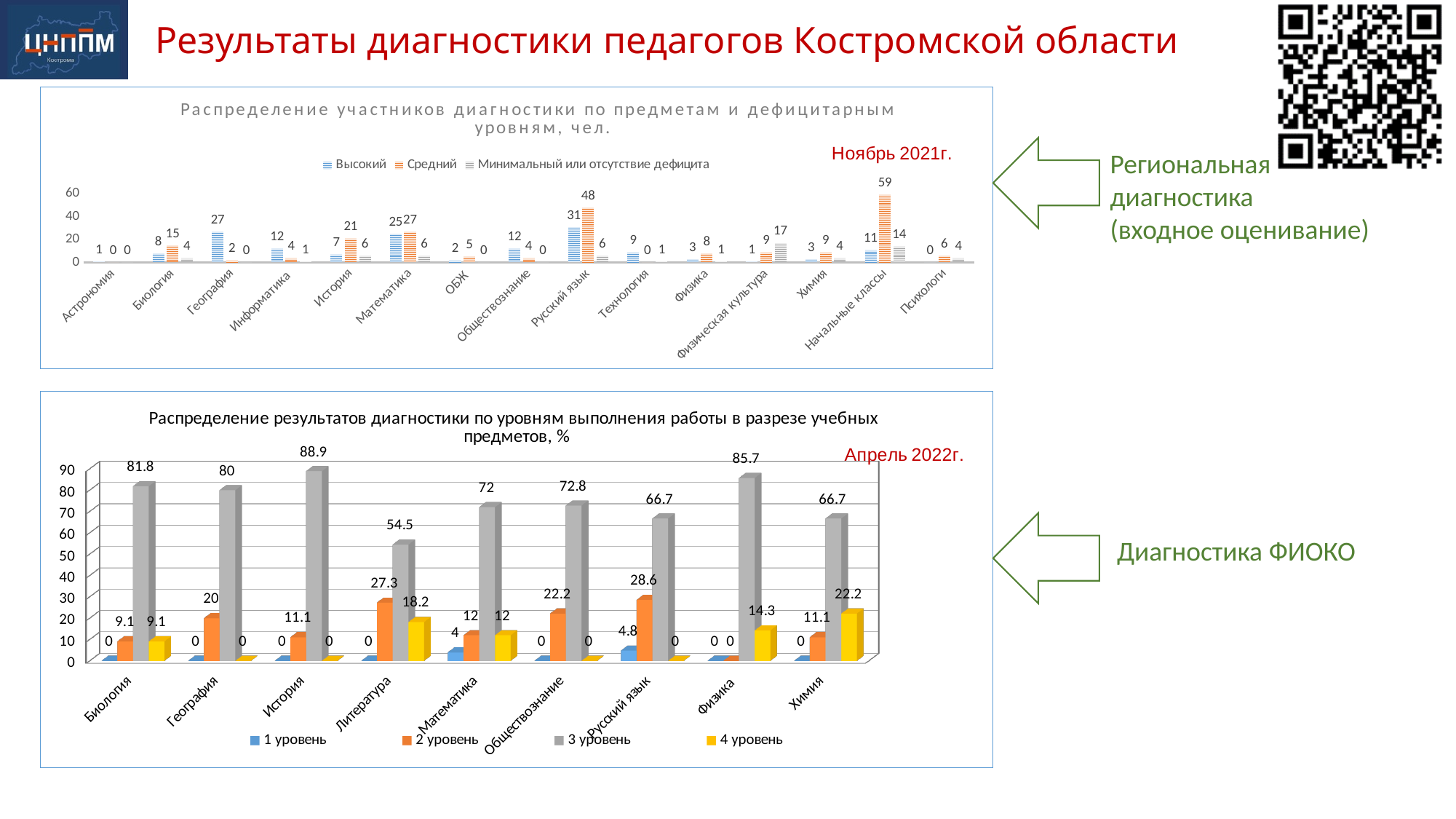
In the bottom chart (Апрель 2022г.), how many series does the legend list? 4 In the top chart (Ноябрь 2021г.), how many series does the legend list? 3 In the bottom chart (Апрель 2022г.), which subject has the lowest value for 3 уровень? Литература In the top chart (Ноябрь 2021г.), what is the value of the Средний series for Начальные классы? 59 In the top chart (Ноябрь 2021г.), how many subject categories are shown on the x axis? 15 In the bottom chart (Апрель 2022г.), which is larger: the 4 уровень value for Химия or for Физика? Химия In the top chart (Ноябрь 2021г.), what is the difference between the Средний and Высокий values for Математика? 2 What type of chart is the bottom chart (Апрель 2022г.)? Bar chart In the top chart (Ноябрь 2021г.), which subject has the highest value in the Высокий series? Русский язык In the bottom chart (Апрель 2022г.), which subject has the highest value for 2 уровень? Русский язык In the top chart (Ноябрь 2021г.), what is the value of the Высокий series for Русский язык? 31 In the bottom chart (Апрель 2022г.), what is the value of 3 уровень for История? 88.9